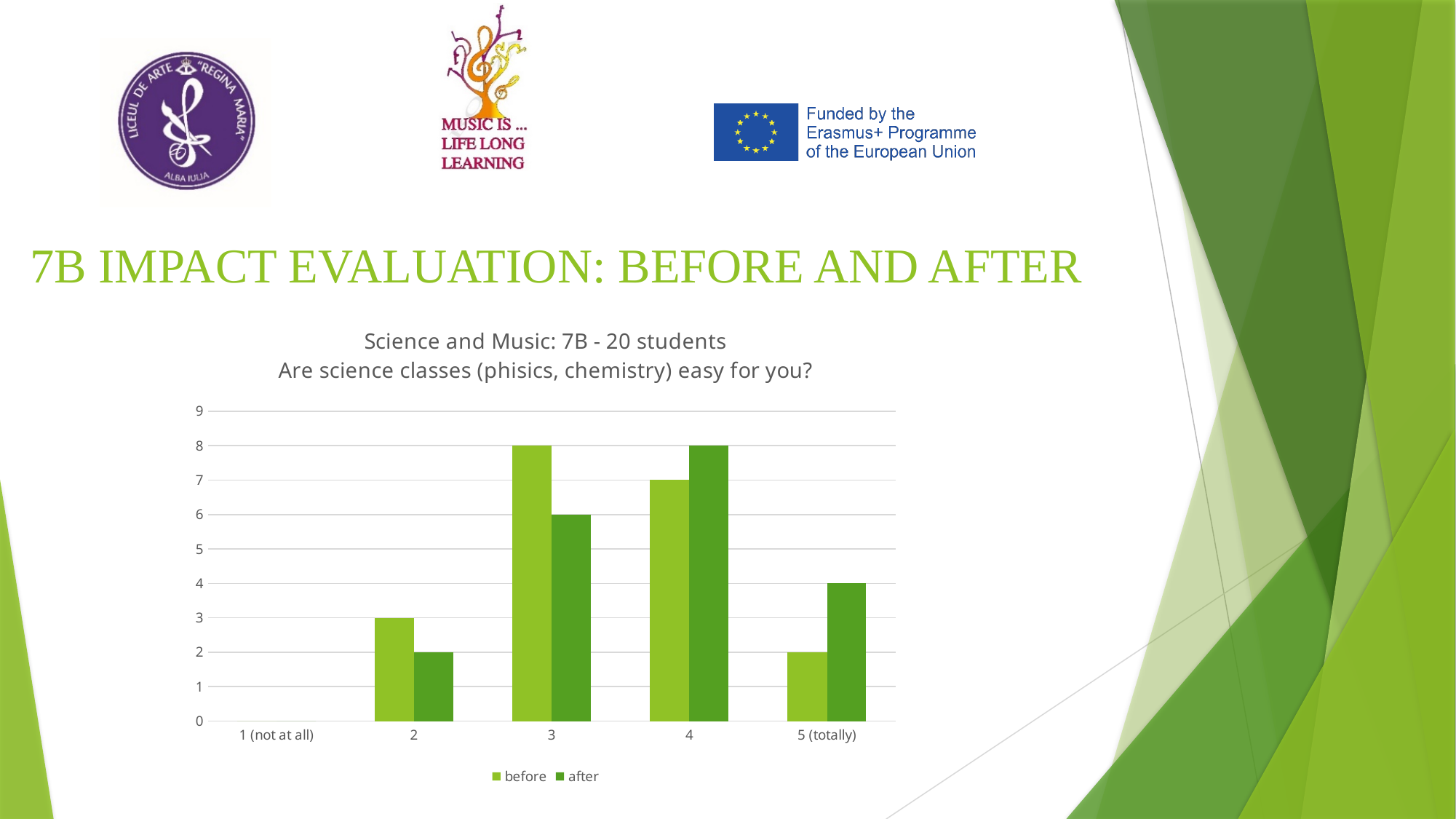
What is the 'before' value for category 3? 8 What is the 'after' value for category 5 (totally)? 4 How many categories are shown on the x axis? 5 What is the difference between the 'before' and 'after' values for category 3? 2 What is the 'before' value for category 2? 3 Which category has the highest 'before' value? 3 What is the 'after' value for category 4? 8 How many series does the legend list? 2 What question is shown in the chart title? Are science classes (phisics, chemistry) easy for you? Which category has the highest 'after' value? 4 What kind of chart is shown on the slide? bar chart Which is larger for category 5 (totally): the 'before' value or the 'after' value? after